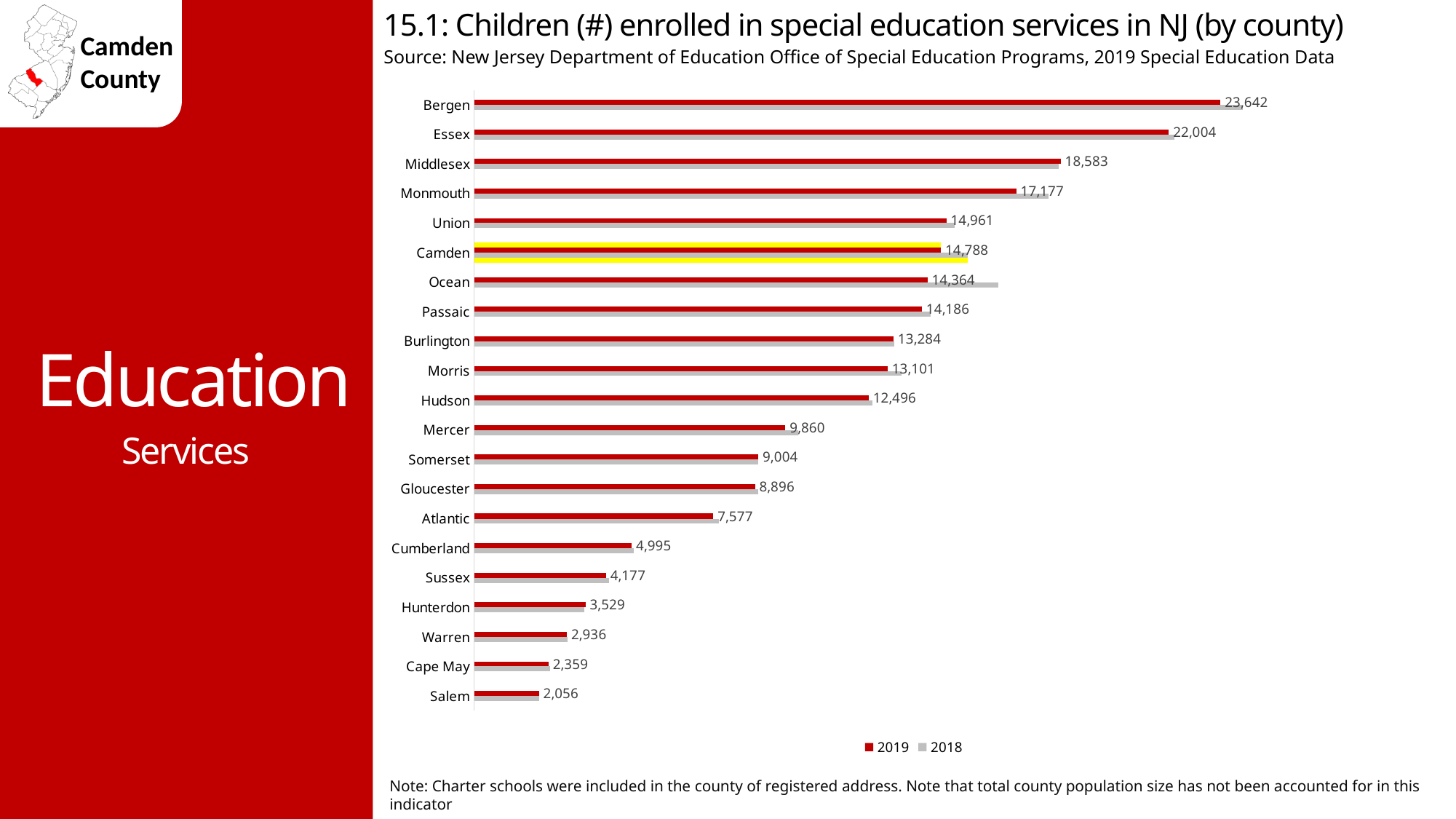
What is the difference between the 2019 values for Camden and Ocean? 424 Which county has the highest 2019 value? Bergen How many series does the legend list? 2 Which county's bars are highlighted in yellow? Camden How many counties are shown on the chart? 21 What is the 2019 value shown for Salem? 2,056 What is the 2019 value for Camden? 14,788 What kind of chart is shown on the slide? Bar chart Which county has the lowest 2019 value? Salem What is the difference between the 2019 values for Bergen and Essex? 1,638 Which county has the larger 2019 value, Union or Camden? Union How many children were enrolled in special education services in Bergen in 2019? 23,642